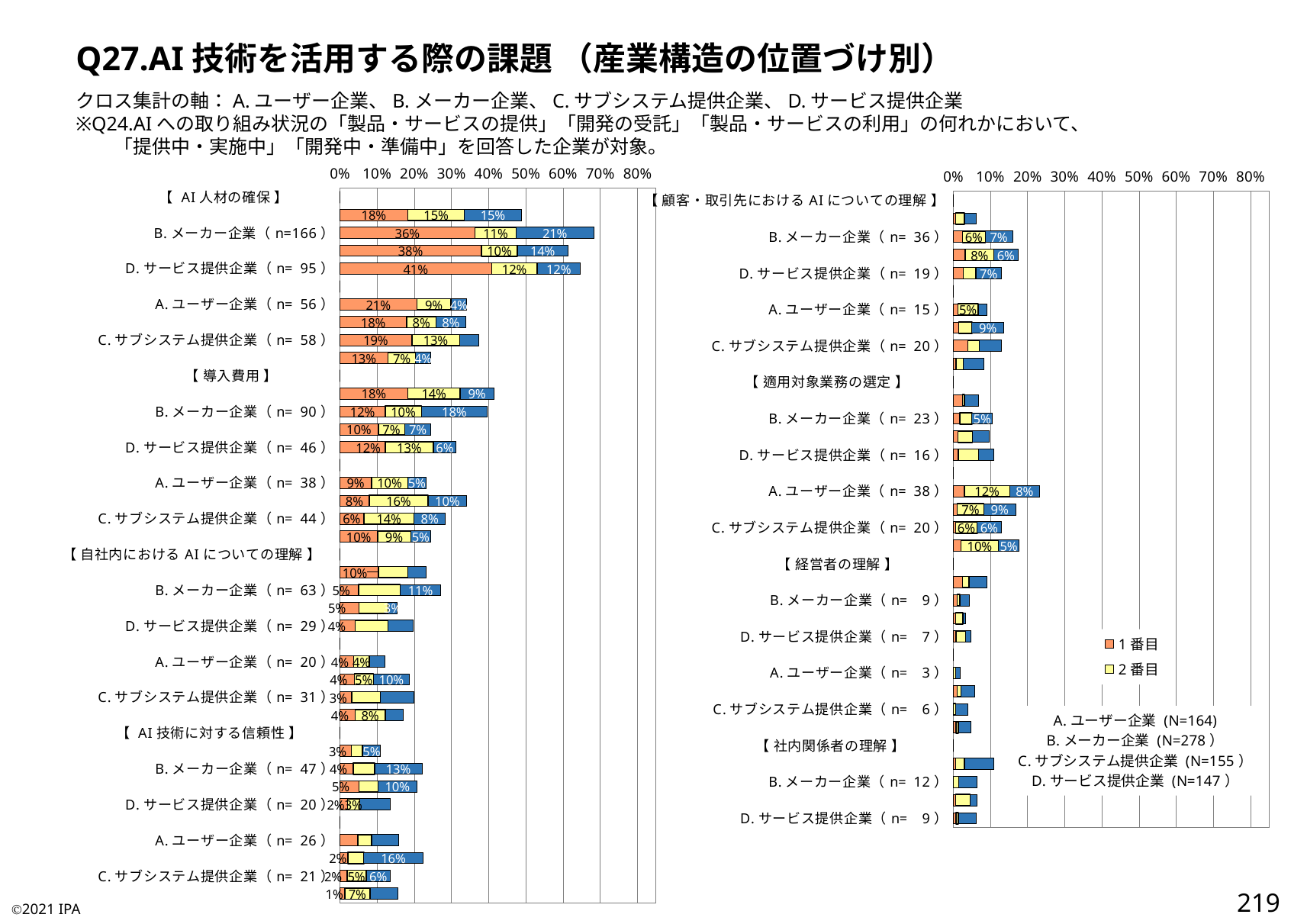
In the left chart, under 【AI人材の確保】, what is the 1番目 value for the bar labelled D. サービス提供企業 (n=95)? 41% In the left chart, under 【AI人材の確保】, what is the total of the three labelled segments of the bar for B. メーカー企業 (n=166)? 68% In the left chart, under 【AI人材の確保】, what is the 1番目 value for the bar labelled B. メーカー企業 (n=166)? 36% In the left chart, under 【AI人材の確保】, which has the larger 1番目 value: B. メーカー企業 (n=166) or D. サービス提供企業 (n=95)? D. サービス提供企業 (n=95) In the left chart, under 【AI人材の確保】, what is the difference between the 1番目 values of D. サービス提供企業 (n=95) and B. メーカー企業 (n=166)? 5% In the left chart, under 【AI人材の確保】, what is the 2番目 value for the bar labelled B. メーカー企業 (n=166)? 11% How many series does the legend on the right chart list? 2 In the right chart, under 【適用対象業務の選定】, is the total length of the bar for A. ユーザー企業 (n=38) greater or less than 30%? less What kind of chart is the left chart on the slide? bar chart In the left chart, under 【AI人材の確保】, which of the four labelled company types has the highest 1番目 value? D. サービス提供企業 (n=95) In the right chart, under 【適用対象業務の選定】, what is the 2番目 value for the bar labelled A. ユーザー企業 (n=38)? 12% In the left chart, under 【AI人材の確保】, what is the 1番目 value for the bar labelled A. ユーザー企業 (n=56)? 21%